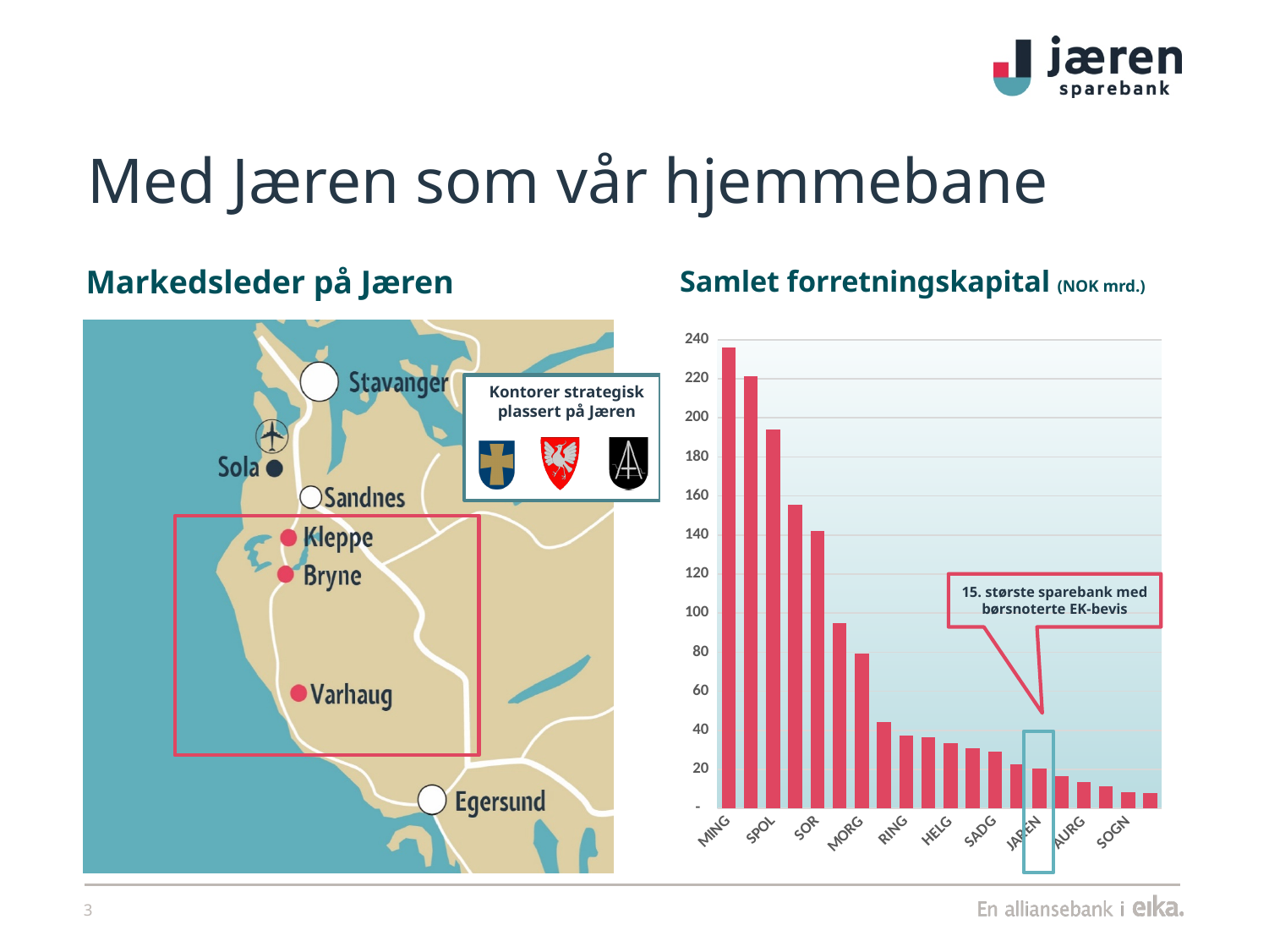
What unit is given in the title of the 'Samlet forretningskapital' chart? NOK mrd. In the 'Samlet forretningskapital' chart, which is larger, the value for MING or the value for SPOL? MING In the 'Samlet forretningskapital' chart, is the value for SOR greater or less than 160? less In the 'Samlet forretningskapital' chart, is the value for MING greater or less than 220? greater In the 'Samlet forretningskapital' chart, is the value for SOGN greater or less than 20? less What does the callout box in the 'Samlet forretningskapital' chart say about the highlighted JAREN bar? 15. største sparebank med børsnoterte EK-bevis In the 'Samlet forretningskapital' chart, which category has the highest value? MING In the 'Samlet forretningskapital' chart, do the values rise or fall from left to right along the x axis? fall What kind of chart is shown under the heading 'Samlet forretningskapital'? Bar chart